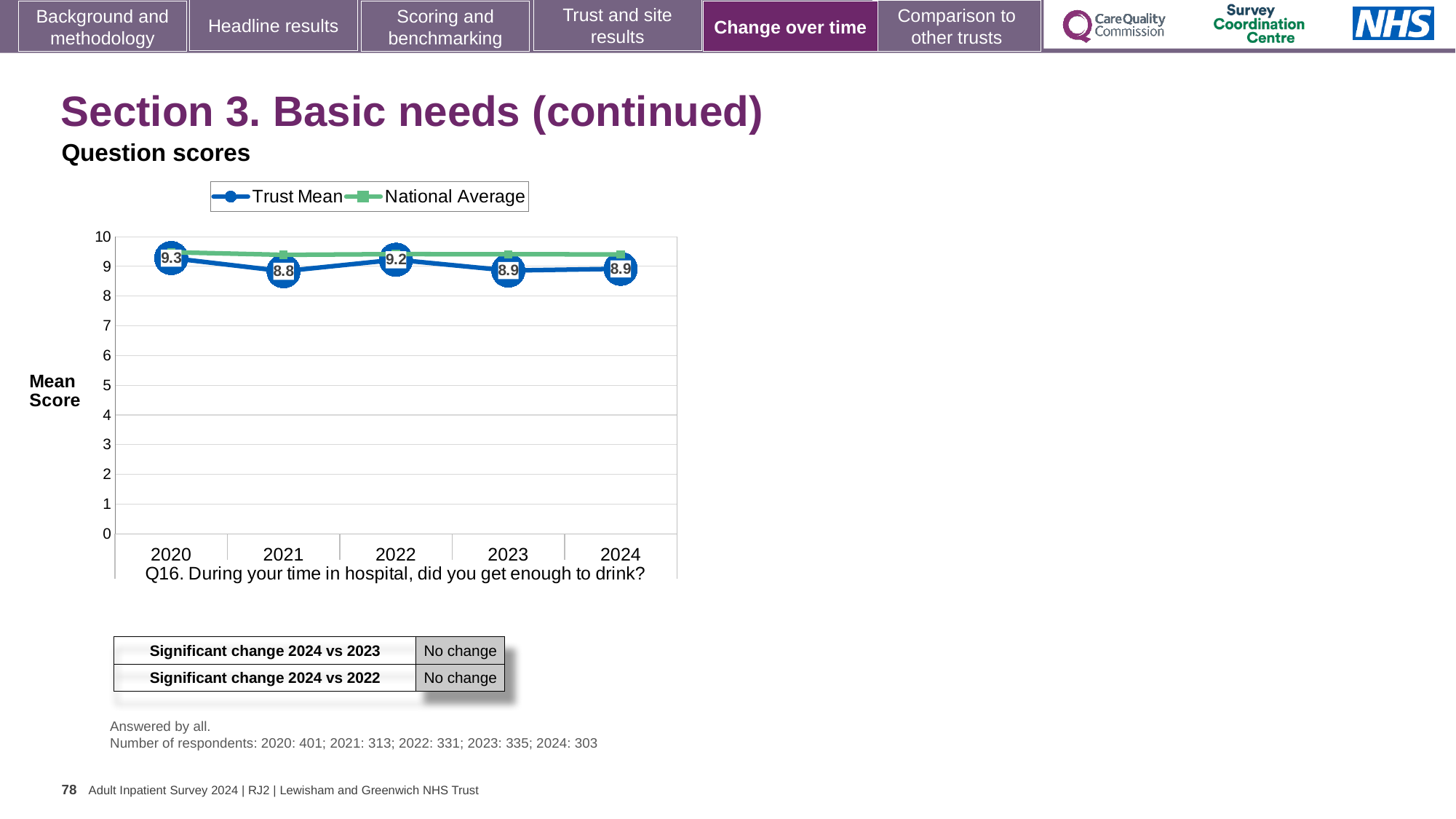
What is the Trust Mean score for 2021? 8.8 Is the National Average value for 2021 greater or less than 9? greater What is the Trust Mean score for 2022? 9.2 What is the Trust Mean score for 2020? 9.3 In which year is the Trust Mean score highest? 2020 How many years are plotted on the x axis? 5 In which year is the Trust Mean score lowest? 2021 Which is larger, the Trust Mean score for 2022 or for 2023? 2022 What is the difference between the Trust Mean scores for 2020 and 2021? 0.5 What kind of chart is shown on the slide? Line chart How many series does the legend list? 2 What is the Trust Mean score for 2024? 8.9